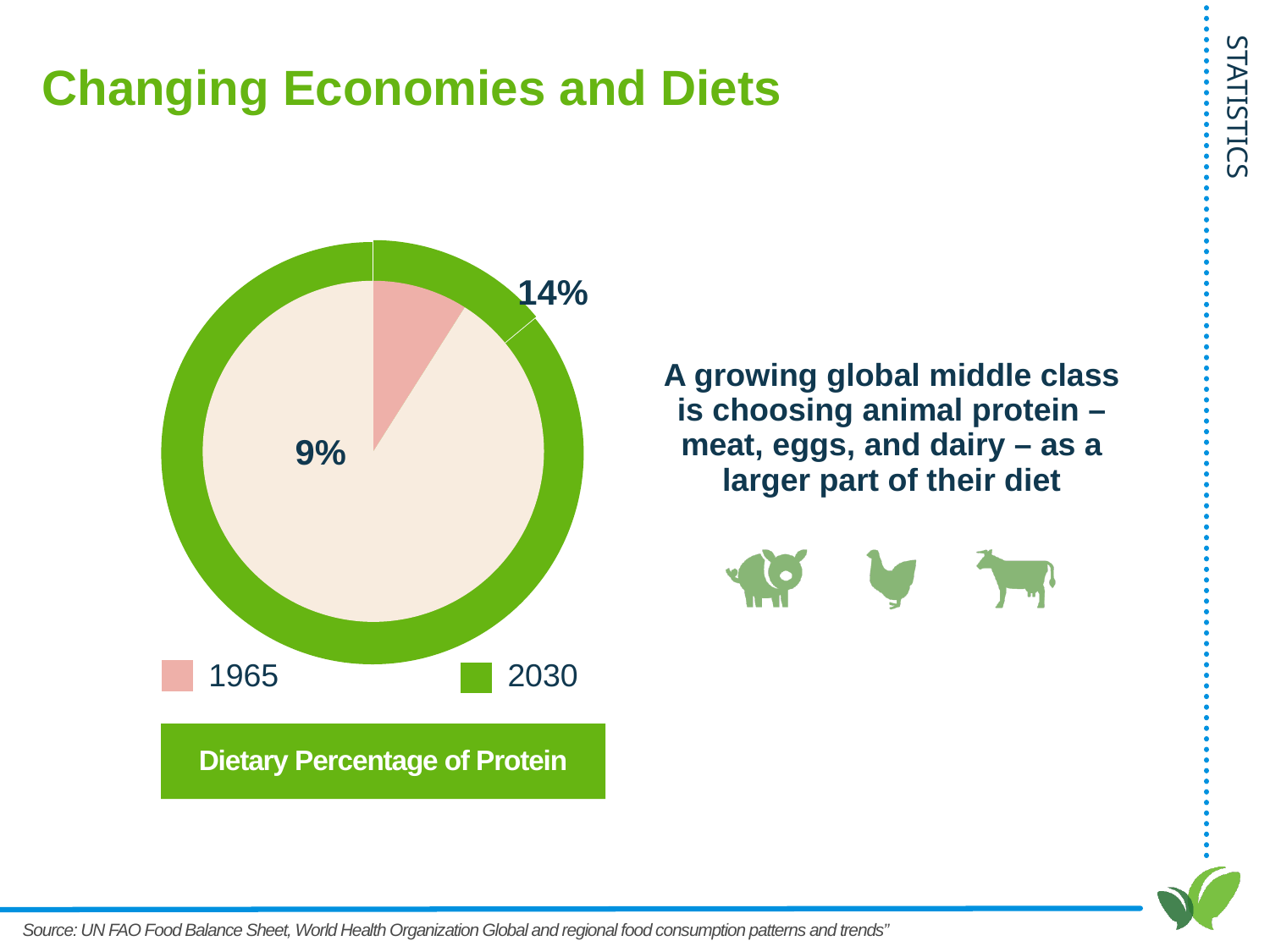
How many entries does the chart legend list? 2 What is the title shown beneath the chart? Dietary Percentage of Protein By how many percentage points does the 2030 value exceed the 1965 value? 5 percentage points Which year shows the highest dietary percentage of protein? 2030 What is the dietary percentage of protein shown for 1965? 9% What is the dietary percentage of protein shown for 2030? 14% Which colour represents 1965 in the chart legend? Pink Which year has the higher dietary percentage of protein, 1965 or 2030? 2030 What kind of chart is used to show the dietary percentage of protein? Pie (doughnut) chart Does the dietary percentage of protein rise or fall from 1965 to 2030? Rise Which year shows the lowest dietary percentage of protein? 1965